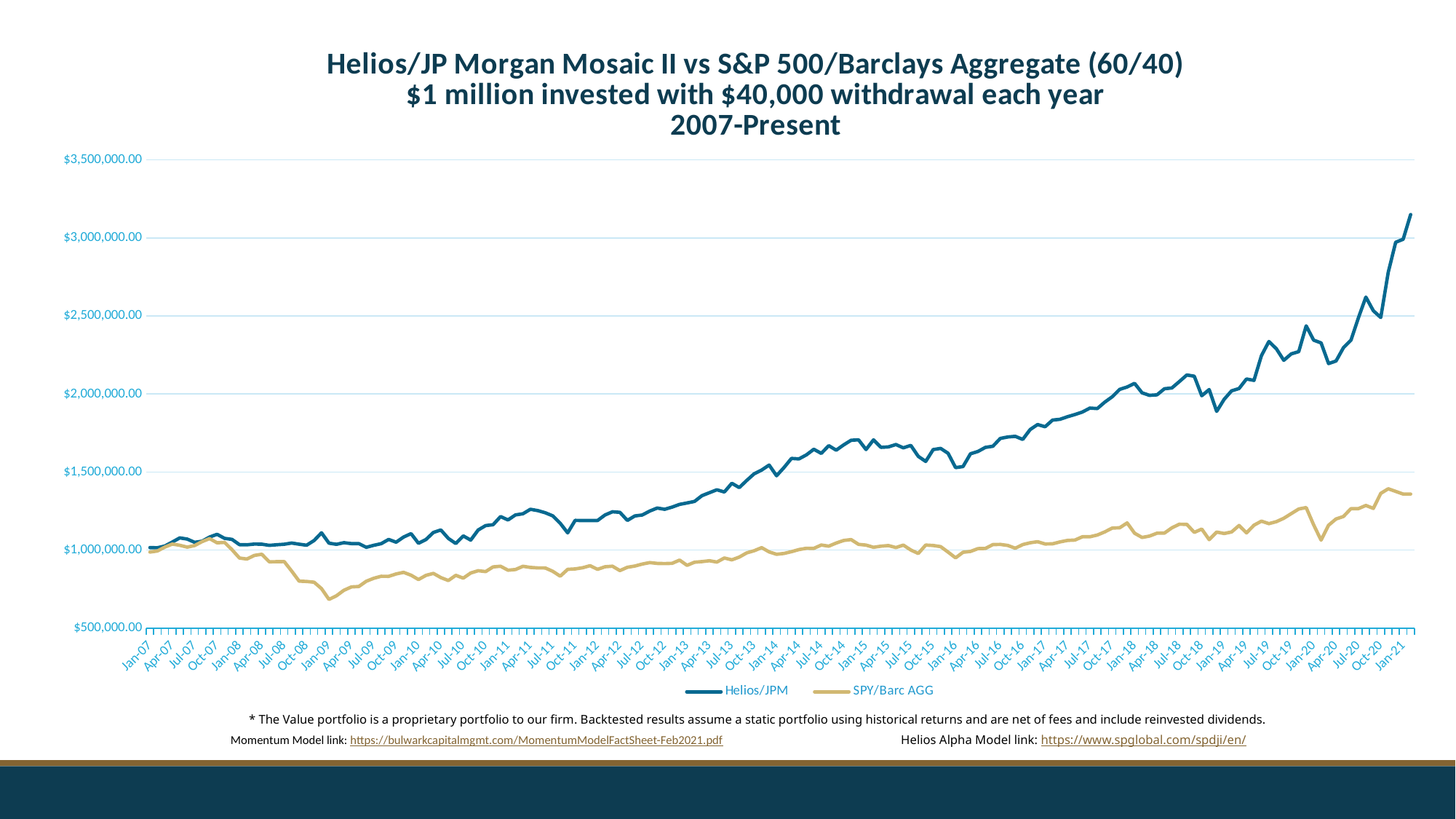
At Jan-09, which series has the higher value, Helios/JPM or SPY/Barc AGG? Helios/JPM What kind of chart is shown on the slide? line chart How many series does the legend list? 2 Overall, does the Helios/JPM line rise or fall from Jan-07 to Jan-21? rise Which series is drawn in dark blue? Helios/JPM Is the value for SPY/Barc AGG at Jan-20 greater or less than $1,000,000.00? greater Is the value for SPY/Barc AGG at Jan-09 greater or less than $1,000,000.00? less Is the value for Helios/JPM at Jan-17 greater or less than $1,500,000.00? greater At Jan-21, which series has the higher value, Helios/JPM or SPY/Barc AGG? Helios/JPM What are the two series named in the legend? Helios/JPM and SPY/Barc AGG